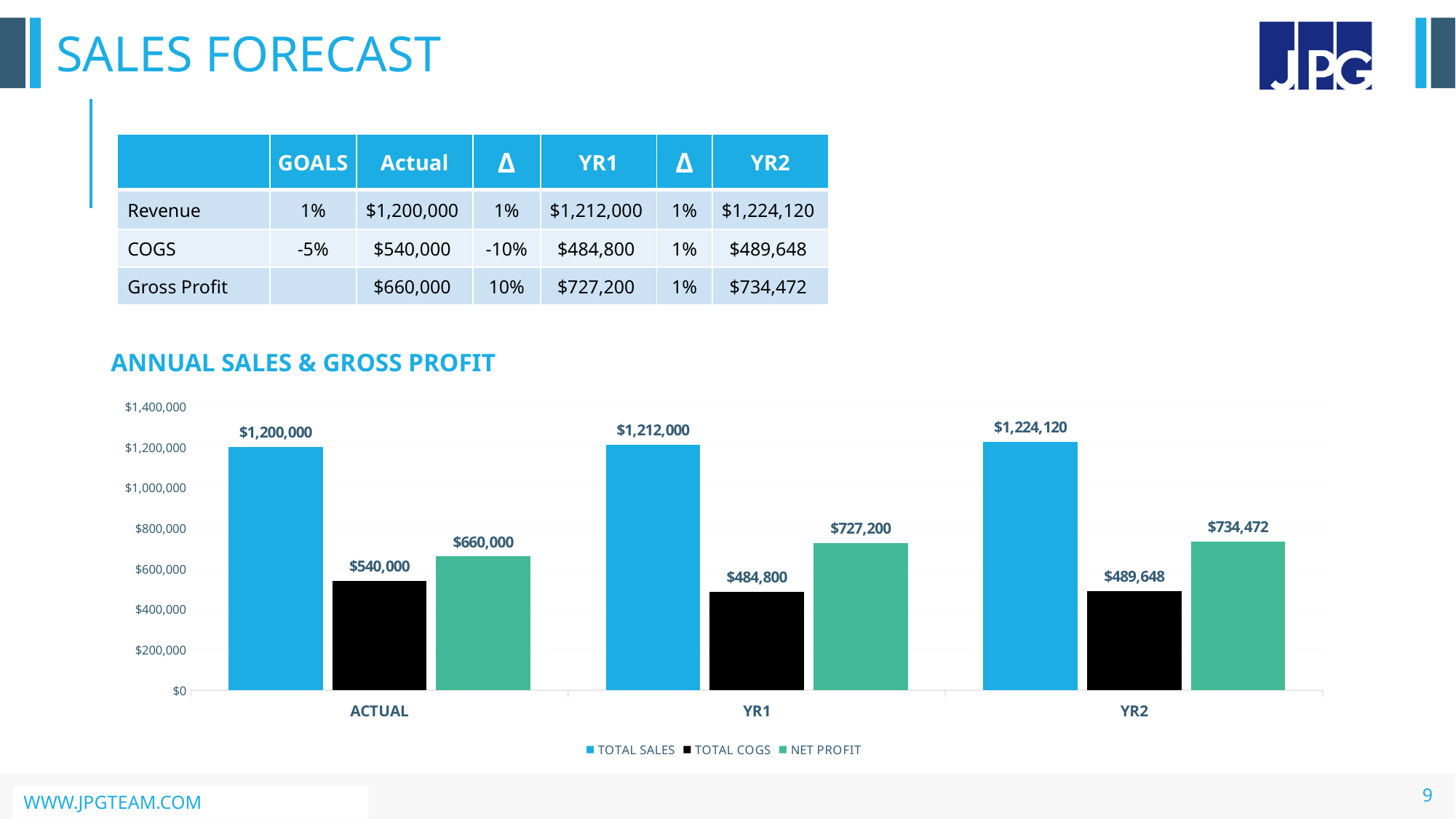
What is the TOTAL COGS value for ACTUAL in the chart? $540,000 What is the NET PROFIT value for YR2 in the chart? $734,472 How many categories are shown on the x axis of the chart? 3 What is the TOTAL SALES value for YR1 in the chart? $1,212,000 Which category has the lowest NET PROFIT value? ACTUAL Which is larger: NET PROFIT for YR1 or NET PROFIT for ACTUAL? NET PROFIT for YR1 What kind of chart is shown on the slide? bar chart Is the TOTAL COGS value for YR1 greater or less than $600,000? less What is the difference between TOTAL SALES and TOTAL COGS for ACTUAL? $660,000 What is the title of the chart? ANNUAL SALES & GROSS PROFIT Which category has the highest TOTAL SALES value? YR2 How many series does the chart legend list? 3